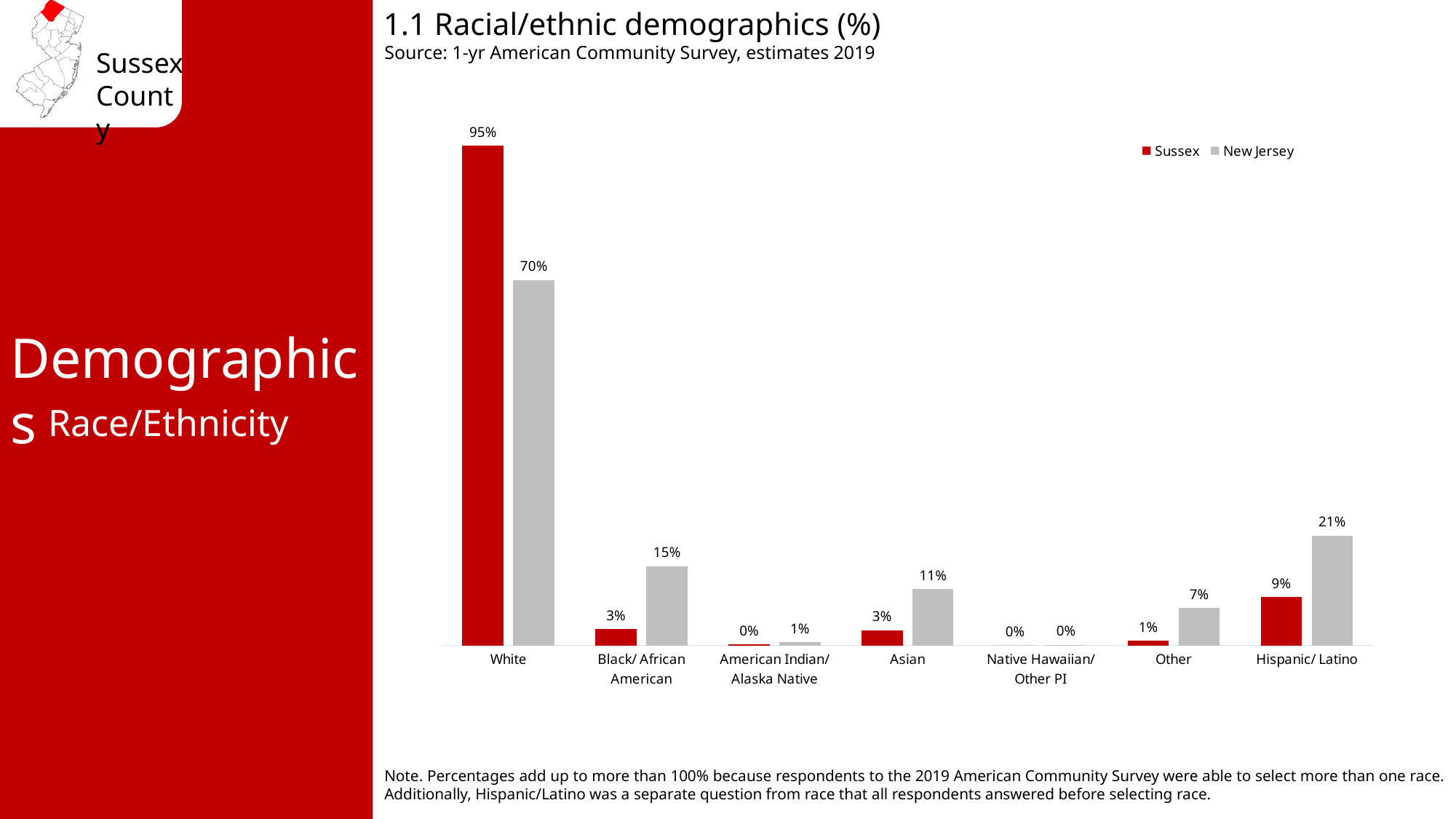
What is the title of the chart? 1.1 Racial/ethnic demographics (%) What is the New Jersey value for Hispanic/ Latino? 21% Which category has the highest New Jersey value? White What is the difference between the New Jersey and Sussex values for Hispanic/ Latino? 12% What is the Sussex value for Asian? 3% What kind of chart is shown? bar chart What is the Sussex value for White? 95% How many series does the legend list? 2 Which is larger for Asian, the Sussex value or the New Jersey value? New Jersey What is the difference between the Sussex and New Jersey values for White? 25% How many categories are shown on the x axis? 7 What is the New Jersey value for Black/ African American? 15%